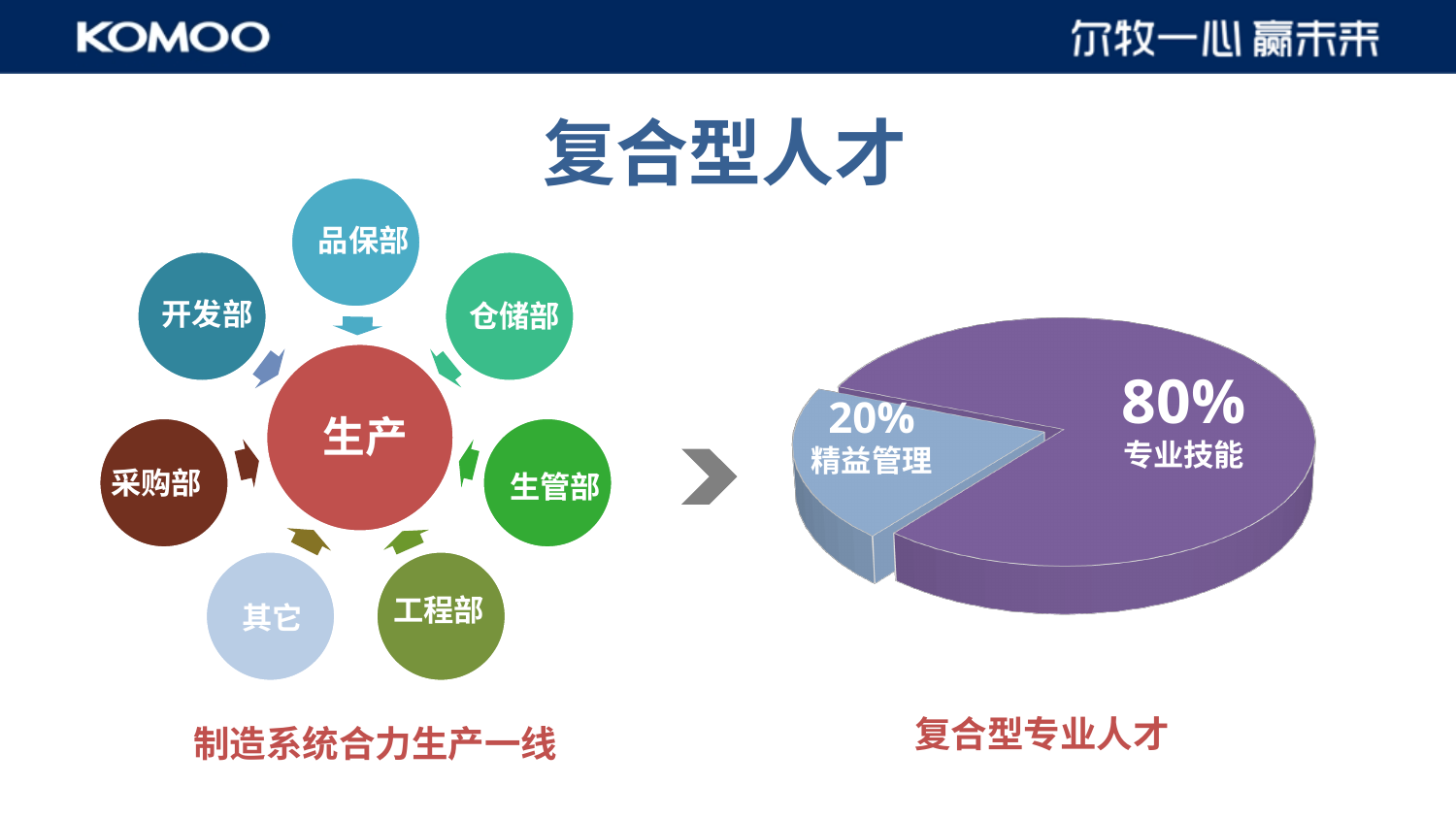
In the pie chart, what share is labelled 精益管理? 20% What colour is the 专业技能 slice of the pie chart? Purple In the pie chart, which is larger: 专业技能 or 精益管理? 专业技能 Which slice of the pie chart is the smallest? 精益管理 What caption appears below the pie chart? 复合型专业人才 Which slice of the pie chart is the largest? 专业技能 What kind of chart is shown on the right side of the slide? Pie chart Is the 精益管理 share in the pie chart greater or less than 50%? less In the pie chart, what share is labelled 专业技能? 80% How many slices does the pie chart have? 2 In the pie chart, what is the difference between the 专业技能 share and the 精益管理 share? 60%